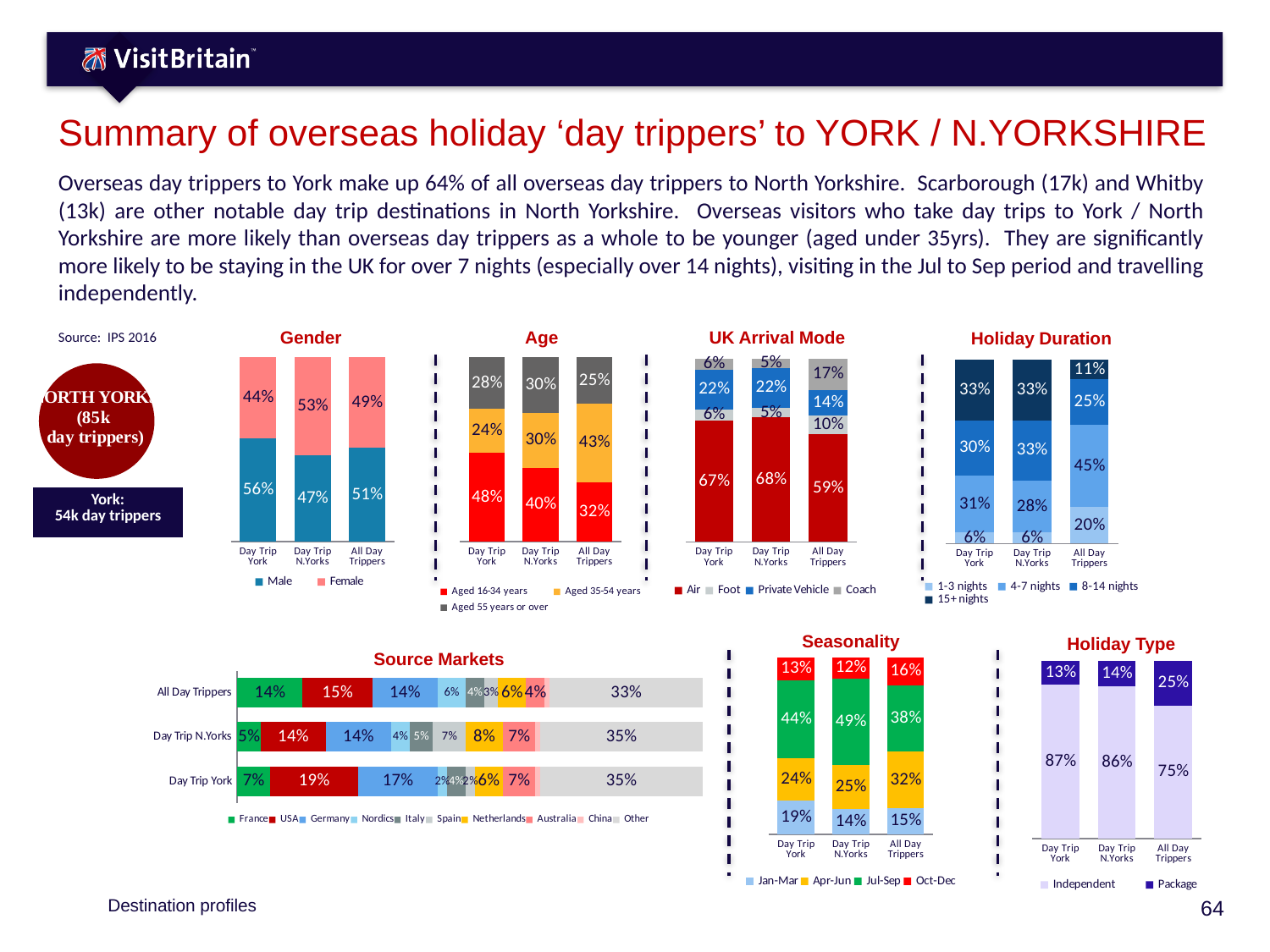
In the Holiday Duration chart, which group has the largest 1-3 nights share? All Day Trippers In the UK Arrival Mode chart, what is the difference between the Air share for Day Trip York and for All Day Trippers? 8% In the Holiday Duration chart, what percentage of Day Trip York visitors stay 15+ nights? 33% In the Age chart, what share of All Day Trippers are Aged 35-54 years? 43% In the Seasonality chart, what is the Jul-Sep share for Day Trip N.Yorks? 49% In the Seasonality chart, is the Jan-Mar share larger for Day Trip York or for Day Trip N.Yorks? Day Trip York In the Source Markets chart, what is the USA share for Day Trip York? 19% In the UK Arrival Mode chart, which of the three groups has the highest Air share? Day Trip N.Yorks What type of chart is the Source Markets chart? Stacked bar chart How many series does the legend of the Seasonality chart list? 4 In the Holiday Type chart, what is the Package share for All Day Trippers? 25% In the Gender chart, what percentage of Day Trip York visitors are Male? 56%